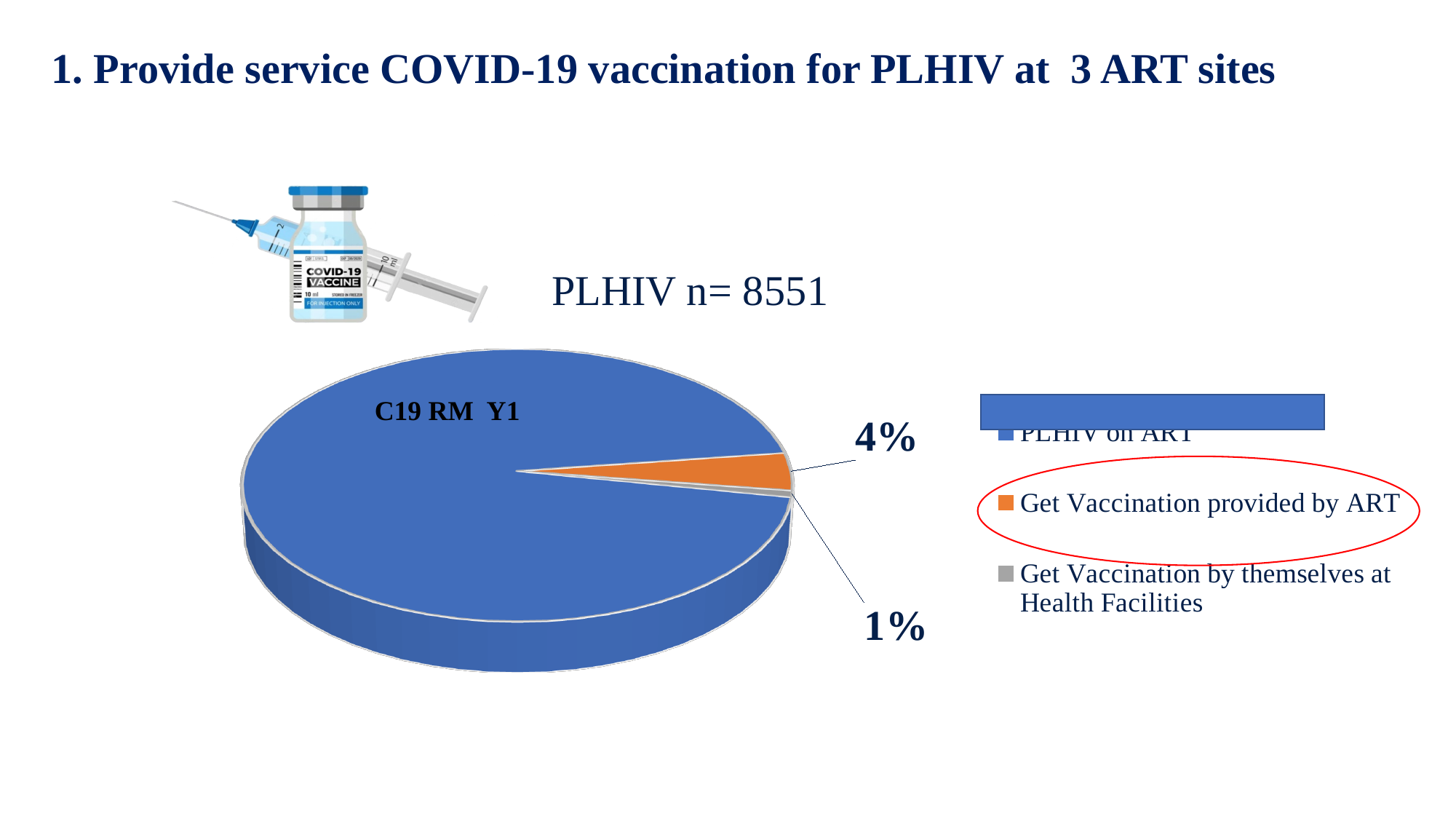
What percentage of the pie is labelled for Get Vaccination by themselves at Health Facilities? 1% What is the title printed on the pie chart? PLHIV n= 8551 What colour is the slice for Get Vaccination provided by ART? orange What kind of chart is shown on the slide? pie chart Which category has the smallest slice of the pie? Get Vaccination by themselves at Health Facilities What is the difference in percentage points between Get Vaccination provided by ART and Get Vaccination by themselves at Health Facilities? 3% What percentage of the pie is labelled for Get Vaccination provided by ART? 4% Which category has the largest slice of the pie? PLHIV on ART Which is larger: Get Vaccination provided by ART or Get Vaccination by themselves at Health Facilities? Get Vaccination provided by ART How many slices does the pie chart have? 3 How many entries does the legend list? 3